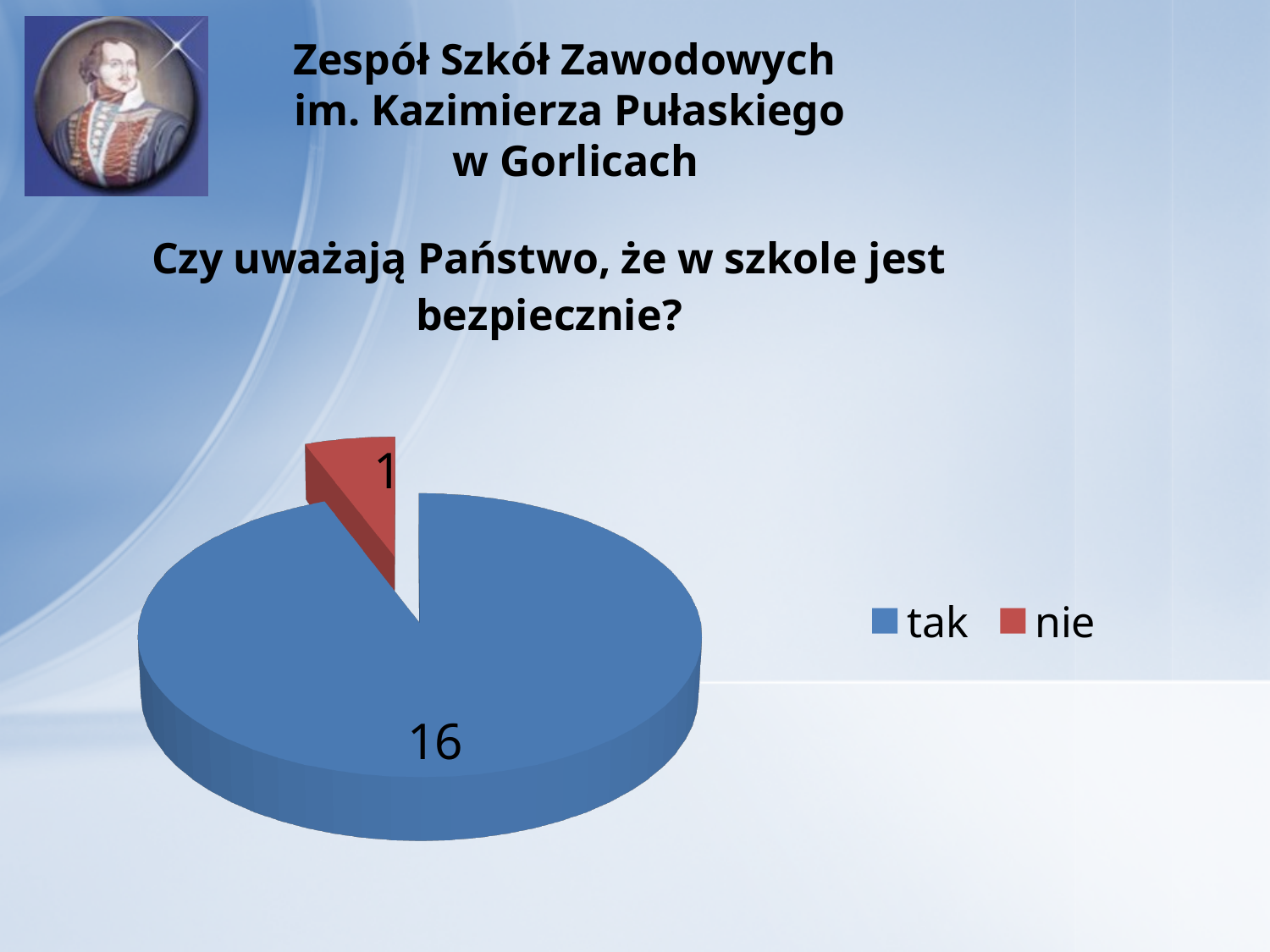
What is the difference between the values for "tak" and "nie"? 15 What question does the chart's title ask? Czy uważają Państwo, że w szkole jest bezpiecznie? How many slices does the pie chart have? 2 What is the value for "tak"? 16 How many entries does the legend list? 2 What is the total of all slices in the pie chart? 17 Which category has the smallest slice? nie What kind of chart is shown on the slide? pie chart What colour is the slice for "nie"? red Which is larger, the value for "tak" or the value for "nie"? tak What is the value for "nie"? 1 Which category has the largest slice? tak